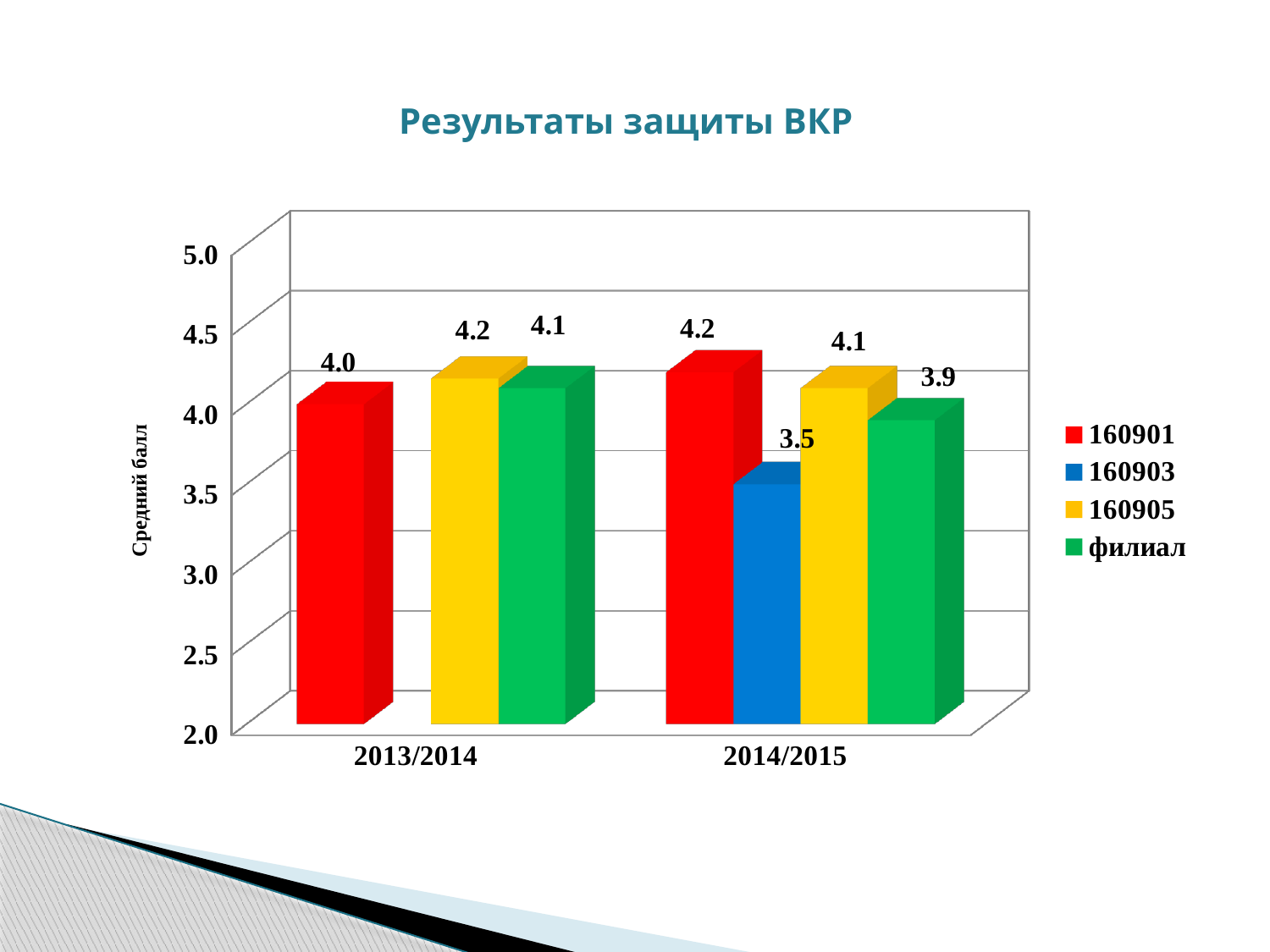
How many series does the legend list? 4 What is the value for 160905 in 2013/2014? 4.2 What is the difference between the 160901 values in 2014/2015 and 2013/2014? 0.2 What kind of chart is shown on the slide? Bar chart What is the value for 160903 in 2014/2015? 3.5 What is the value for филиал in 2014/2015? 3.9 Which series has the highest value in 2014/2015? 160901 What is the title of the chart? Результаты защиты ВКР How many categories are shown on the x axis? 2 Which series has the lowest value in 2014/2015? 160903 Which is larger: the value for 160905 in 2014/2015 or the value for 160903 in 2014/2015? 160905 What is the value for 160901 in 2013/2014? 4.0